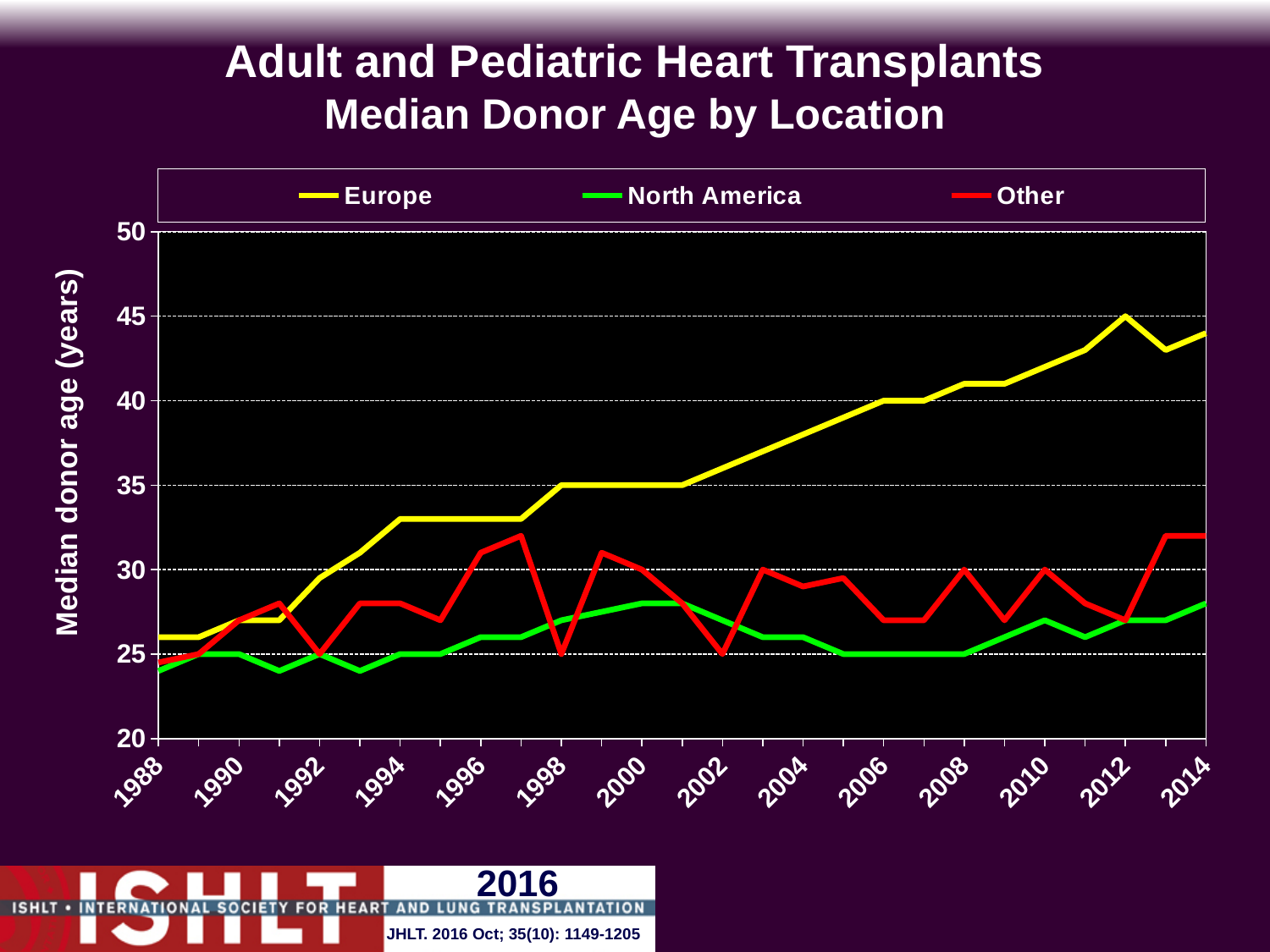
How many series does the legend list? 3 What is the median donor age for Europe in 2012? 45 In 2010, which is larger: the median donor age for Other or for North America? Other What is the median donor age for North America in 2006? 25 Does the median donor age for Europe generally rise or fall from 1988 to 2014? rise Which series has the highest median donor age in 2014? Europe Which series is shown in yellow? Europe What kind of chart is shown on the slide? line chart What is the median donor age for Europe in 2006? 40 Which series has the lowest median donor age in 2000? North America Is the median donor age for Europe in 2014 greater or less than 40? greater